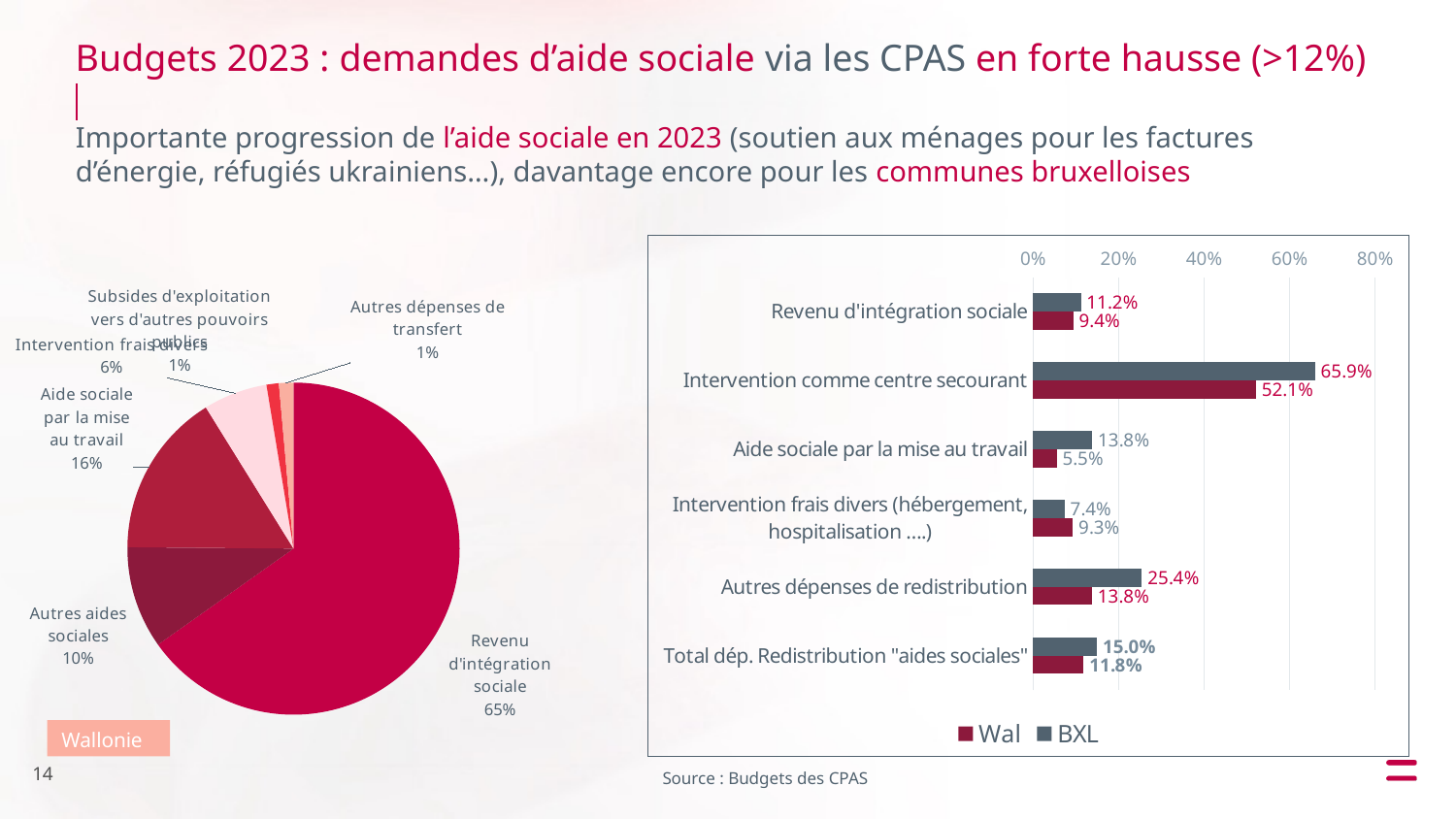
How many slices does the pie chart on the left have? 6 In the bar chart on the right, what is the Wal value for 'Aide sociale par la mise au travail'? 5.5% In the pie chart on the left, what share does 'Aide sociale par la mise au travail' represent? 16% In the bar chart on the right, what is the difference between the BXL and Wal values for 'Autres dépenses de redistribution'? 11.6% In the pie chart on the left, which slice is the largest? Revenu d'intégration sociale In the bar chart on the right, what is the Wal value for 'Total dép. Redistribution "aides sociales"'? 11.8% In the bar chart on the right, which category has the highest BXL value? Intervention comme centre secourant How many series does the legend of the bar chart on the right list? 2 What type of chart is shown on the right side of the slide? Bar chart In the bar chart on the right, which is larger for 'Intervention frais divers (hébergement, hospitalisation ....)': the Wal value or the BXL value? Wal In the pie chart on the left, what share does 'Revenu d'intégration sociale' represent? 65% In the bar chart on the right, what is the BXL value for 'Intervention comme centre secourant'? 65.9%